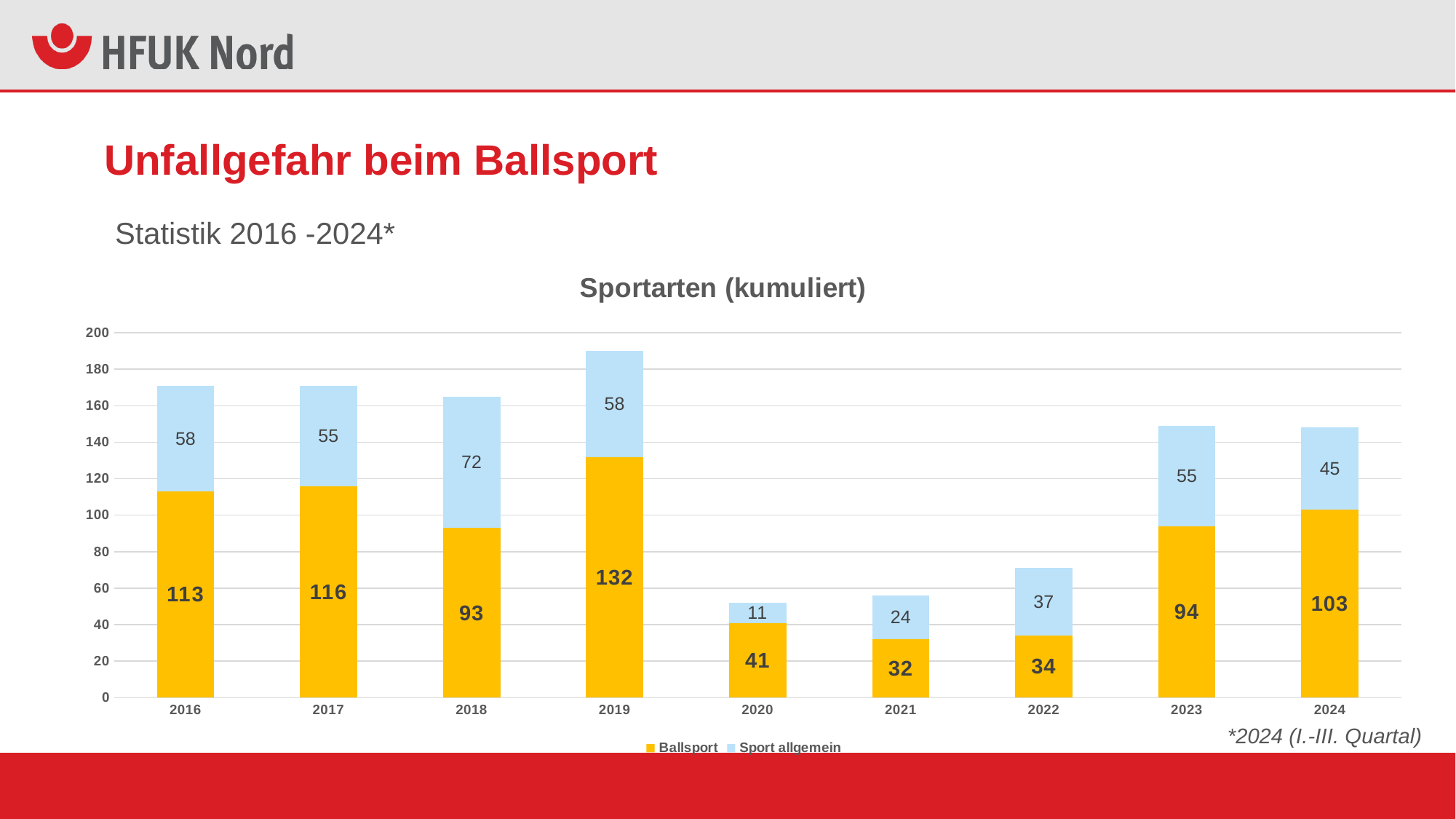
How many series does the legend list? 2 What is the Ballsport value for 2019? 132 How many years are shown on the x axis? 9 What is the total of the stacked bar for 2020? 52 Which year has the highest Ballsport value? 2019 Which is larger, the Ballsport value for 2023 or for 2024? 2024 What is the difference between the Ballsport values for 2017 and 2016? 3 What kind of chart is shown? Stacked bar chart What is the title of the chart? Sportarten (kumuliert) What is the Sport allgemein value for 2018? 72 Which year has the lowest Sport allgemein value? 2020 What is the total of the stacked bar for 2019? 190